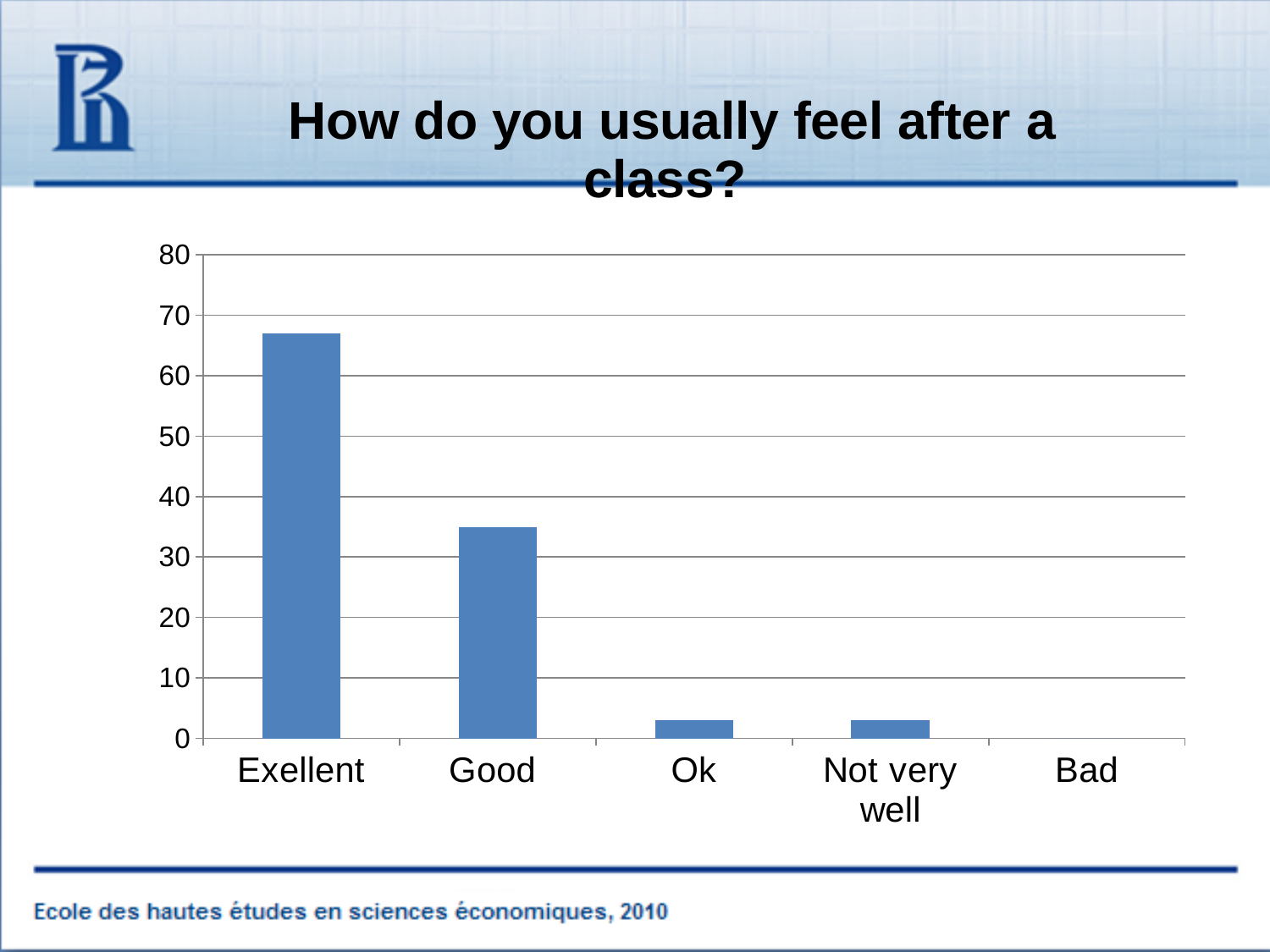
Which category has the highest bar? Exellent Is the value for Ok greater or less than 10? less Is the value for Not very well greater or less than 10? less Which category has the lowest value? Bad What is the title of the slide containing the chart? How do you usually feel after a class? Is the value for Good greater or less than 40? less What kind of chart is shown on the slide? bar chart How many categories are shown on the x axis of the chart? 5 Which is larger, the value for Exellent or the value for Good? Exellent Do the values generally rise or fall from left to right along the x axis? fall